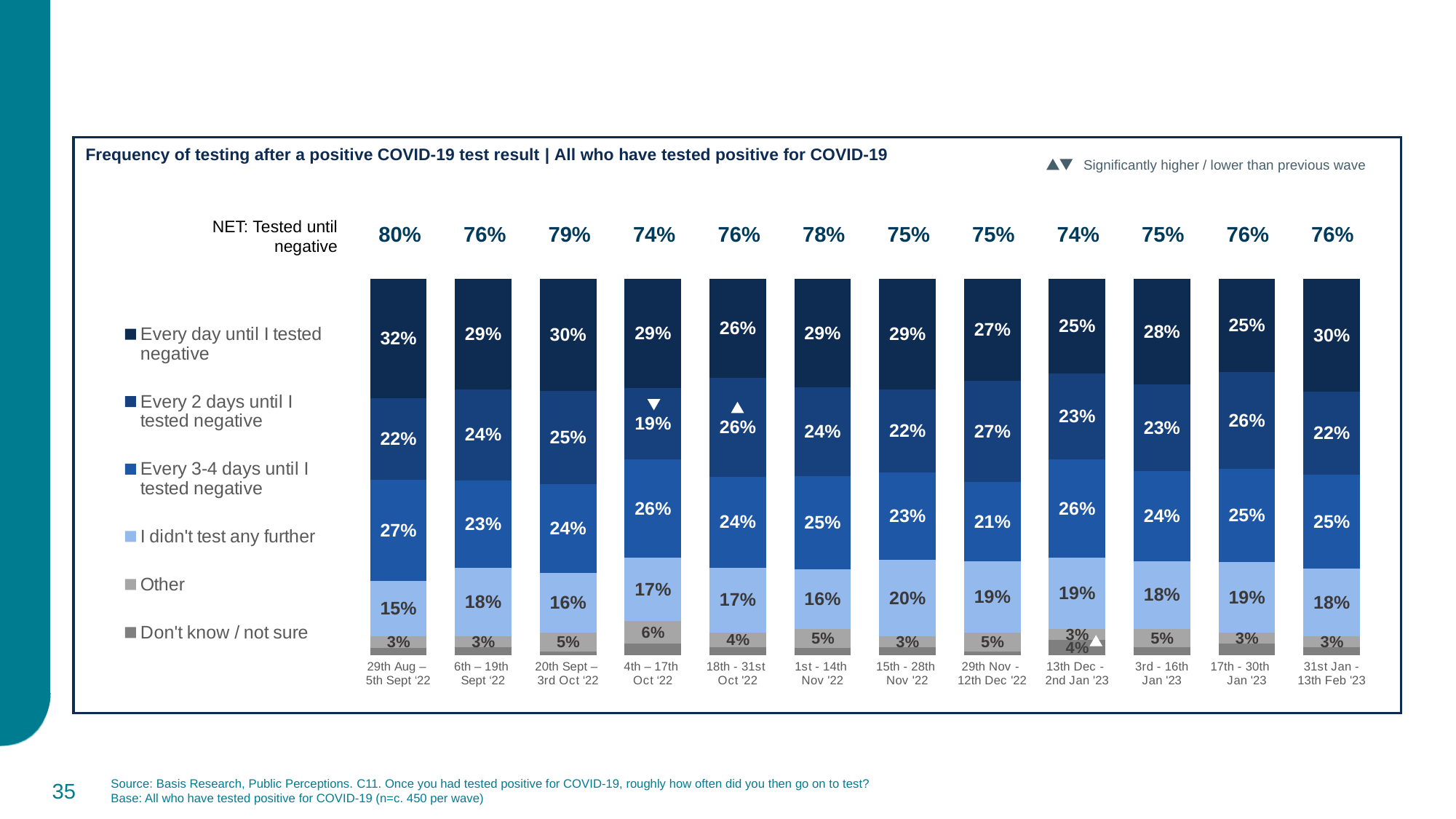
What do the up and down triangles on the chart indicate? Significantly higher / lower than previous wave Which wave has the larger 'Every 2 days until I tested negative' share: 4th – 17th Oct '22 or 18th - 31st Oct '22? 18th - 31st Oct '22 By how many percentage points does the 'Every day until I tested negative' share in the 29th Aug – 5th Sept '22 wave exceed that in the 6th – 19th Sept '22 wave? 3 percentage points What is the NET: Tested until negative figure for the 4th – 17th Oct '22 wave? 74% What percentage of respondents in the 29th Nov - 12th Dec '22 wave said they tested every 3-4 days until they tested negative? 21% What percentage of respondents in the 4th – 17th Oct '22 wave answered 'Other'? 6% Which wave has the highest NET: Tested until negative figure? 29th Aug – 5th Sept '22 What percentage of respondents in the 29th Aug – 5th Sept '22 wave said they tested every day until they tested negative? 32% How many categories does the legend list? 6 How many survey waves are shown on the chart? 12 In which wave is the 'I didn't test any further' share highest? 15th - 28th Nov '22 What type of chart is shown on the slide? Stacked bar chart